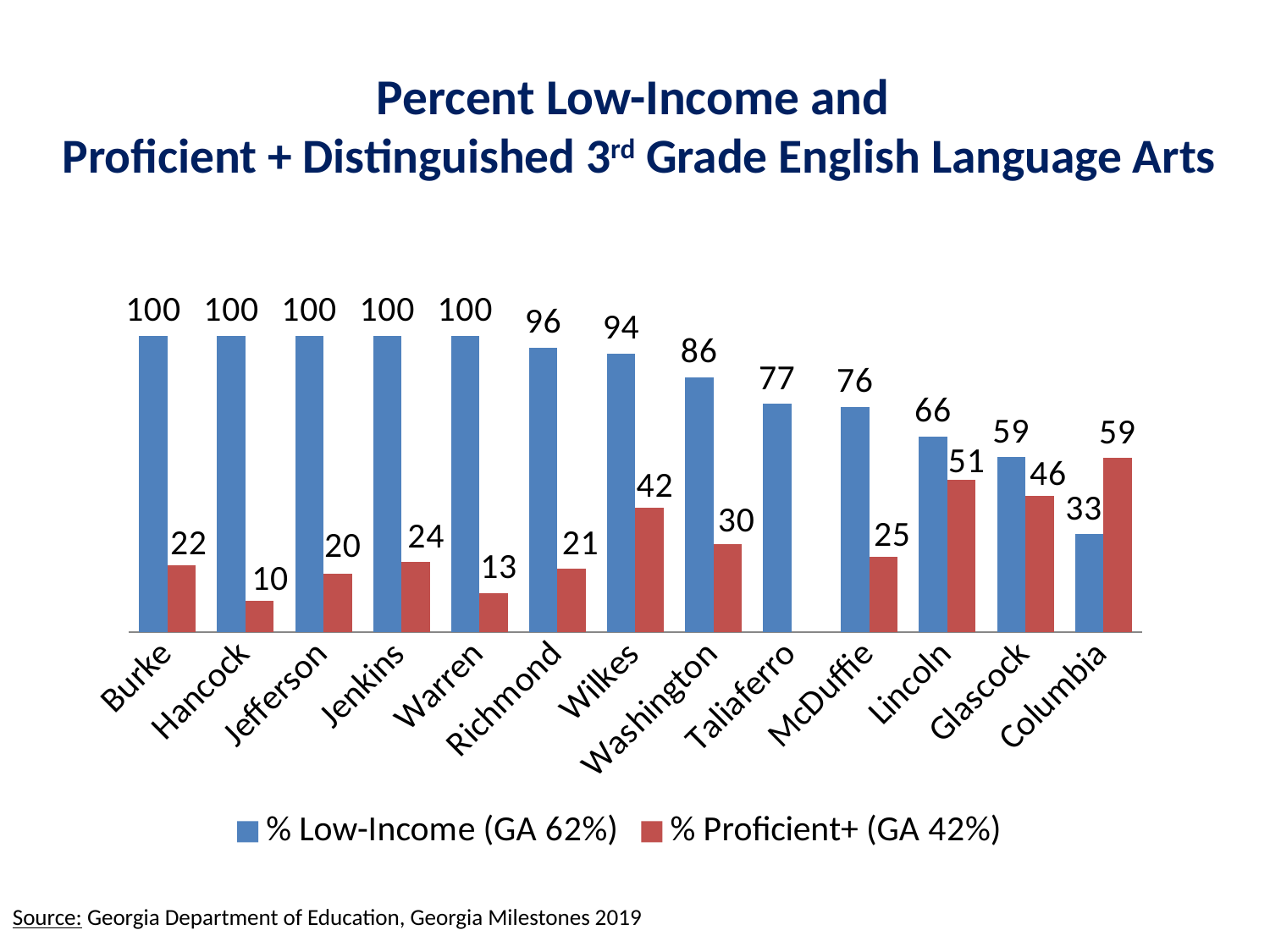
What is the % Proficient+ value for Wilkes? 42 What kind of chart is shown on the slide? Bar chart Do the % Low-Income values rise or fall from left to right along the x axis? Fall What is the % Low-Income value for Richmond? 96 What is the % Proficient+ value for McDuffie? 25 What is the difference between the % Low-Income and % Proficient+ values for Lincoln? 15 Which county has the highest % Proficient+ value? Columbia Which county has the lowest % Proficient+ value? Hancock Which county has the larger % Proficient+ value, Glascock or Lincoln? Lincoln How many counties are shown on the x axis? 13 Which county has the lowest % Low-Income value? Columbia How many series does the legend list? 2